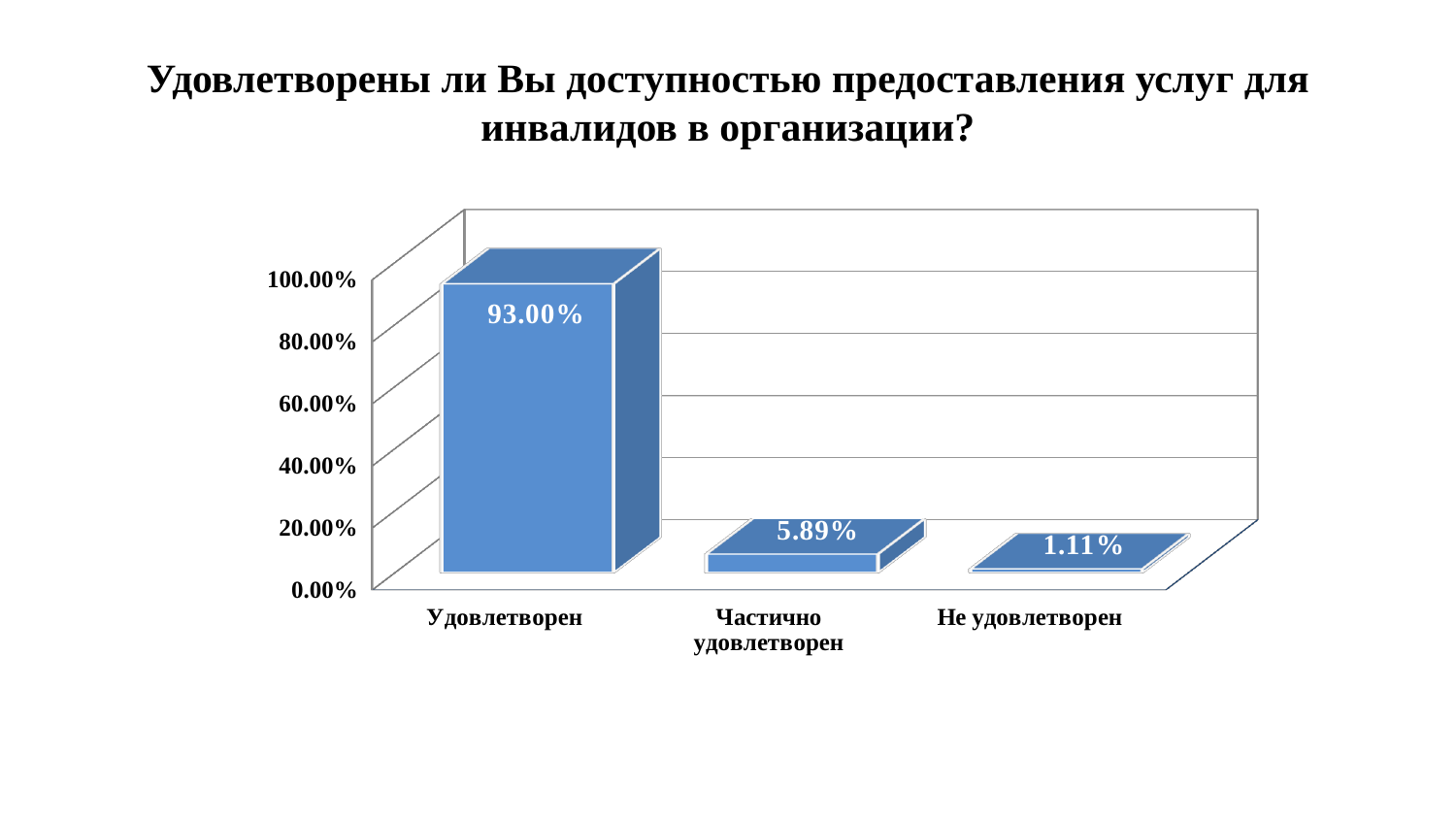
What kind of chart is shown on the slide? bar chart What is the difference between the values for Частично удовлетворен and Не удовлетворен? 4.78% What is the difference between the values for Удовлетворен and Частично удовлетворен? 87.11% Do the values rise or fall from left to right along the x axis? fall Which category has the highest value? Удовлетворен What is the value for Удовлетворен? 93.00% Is the value for Удовлетворен greater or less than 80.00%? greater What is the value for Частично удовлетворен? 5.89% Which is larger, the value for Частично удовлетворен or the value for Не удовлетворен? Частично удовлетворен What is the value for Не удовлетворен? 1.11% How many categories are shown on the x axis? 3 Which category has the lowest value? Не удовлетворен